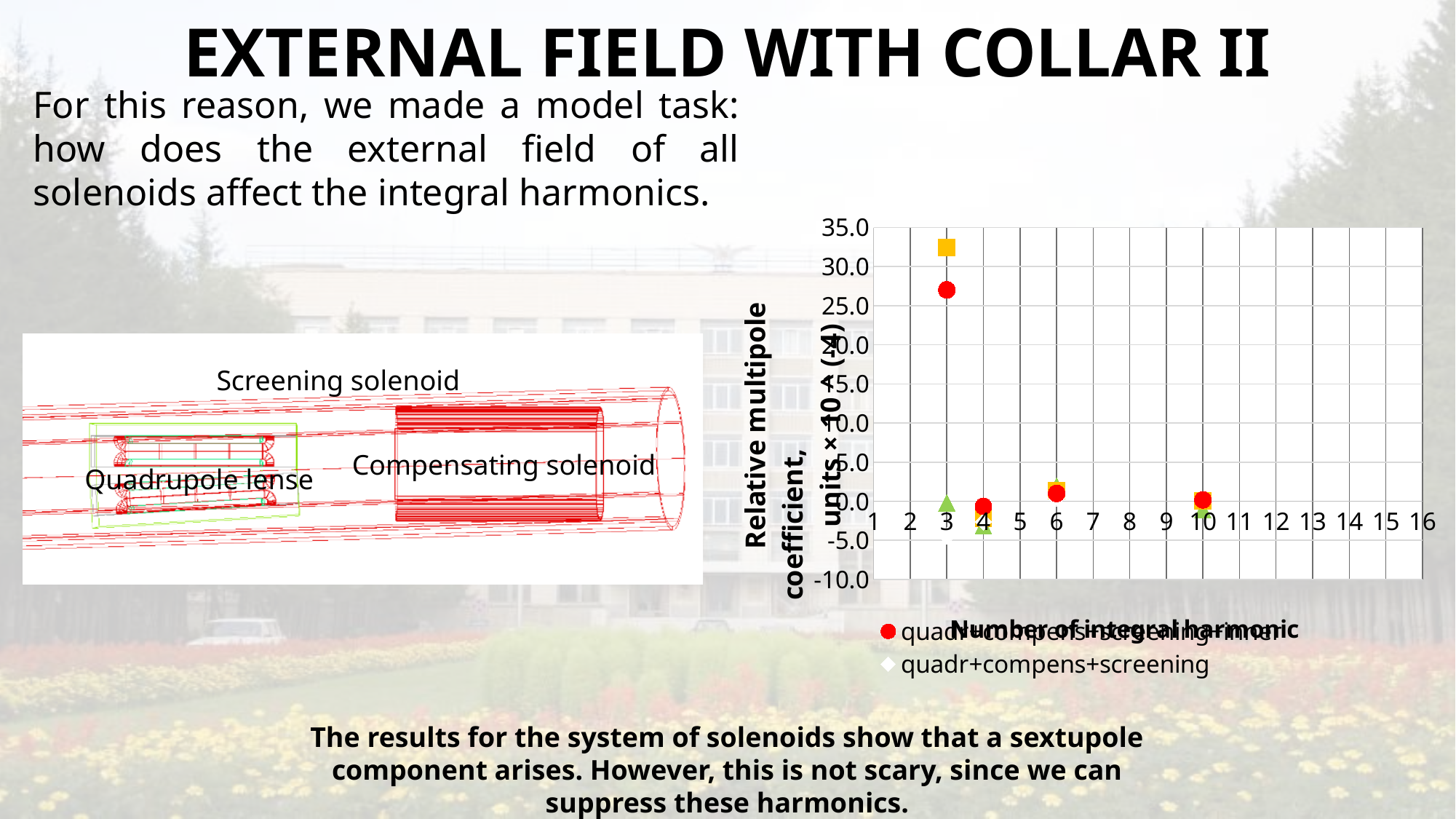
At harmonic 3, which marker is higher: the orange square or the red circle? orange square How many harmonic numbers are labelled along the x axis of the chart? 16 Is the value of the red circle marker at harmonic 3 greater or less than 25.0? greater At which harmonic number do the plotted points reach their highest value? 3 What is the title of the x axis of the chart? Number of integral harmonic Is the value of the red circle marker at harmonic 6 greater or less than 5.0? less Is the value of the red circle marker at harmonic 3 greater or less than 30.0? less Do the plotted values rise or fall from harmonic 3 to harmonic 4? fall What is the highest value shown on the y axis of the chart? 35.0 What kind of chart is shown on the slide? scatter chart